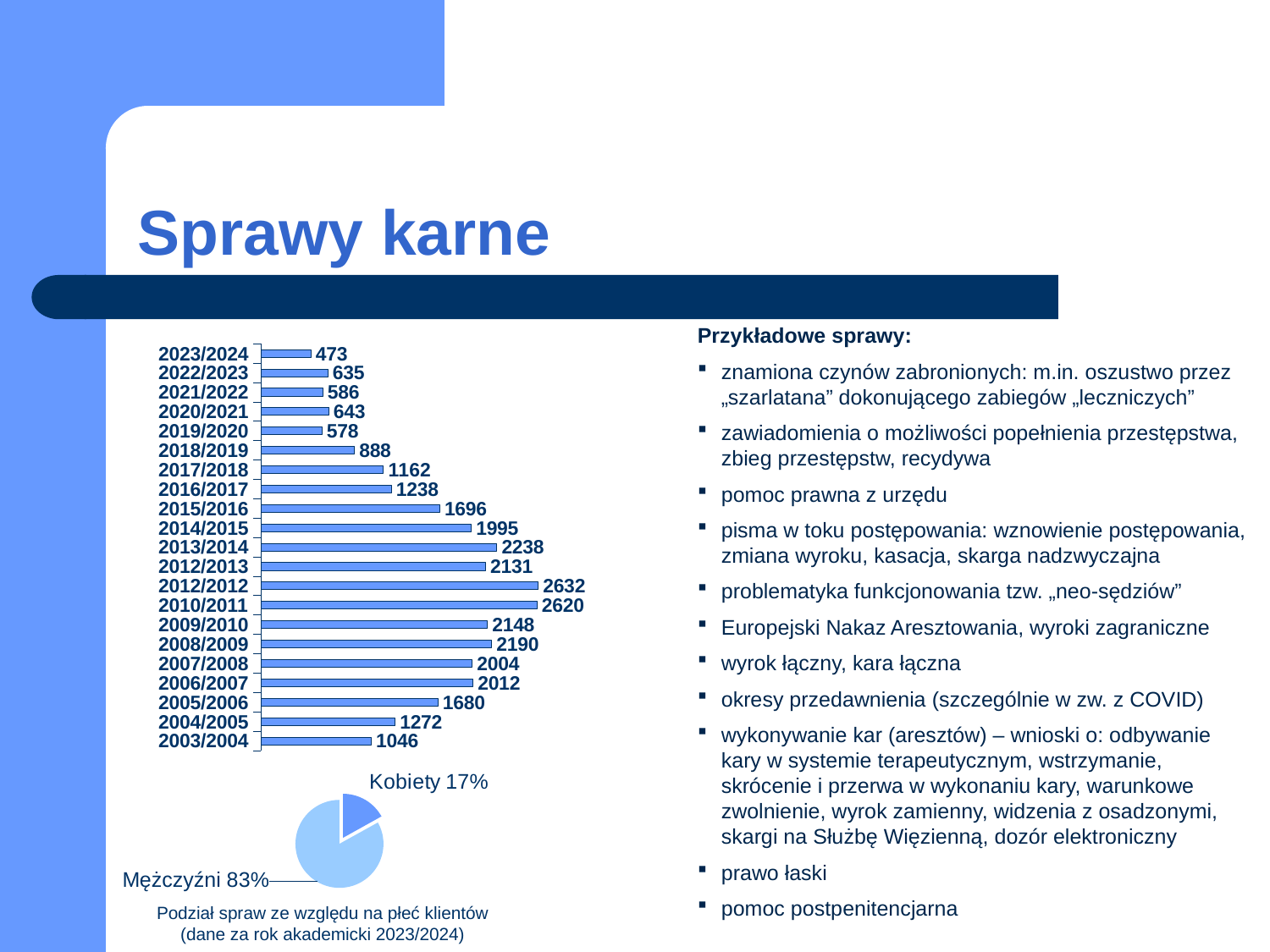
In the bar chart, what is the value for 2023/2024? 473 How many academic years are shown in the bar chart? 21 What type of chart is the chart showing values by academic year? bar chart In the bar chart, which is larger: the value for 2018/2019 or the value for 2017/2018? 2017/2018 In the bar chart, what is the difference between the values for 2013/2014 and 2012/2013? 107 In the bar chart, which academic year has the highest value? 2012/2012 In the bar chart, what is the value for 2003/2004? 1046 In the pie chart 'Podział spraw ze względu na płeć klientów', what share is Kobiety? 17% In the bar chart, what is the value for 2015/2016? 1696 In the bar chart, which academic year has the lowest value? 2023/2024 What type of chart is the chart titled 'Podział spraw ze względu na płeć klientów'? pie chart In the pie chart 'Podział spraw ze względu na płeć klientów', what share is Mężczyźni? 83%